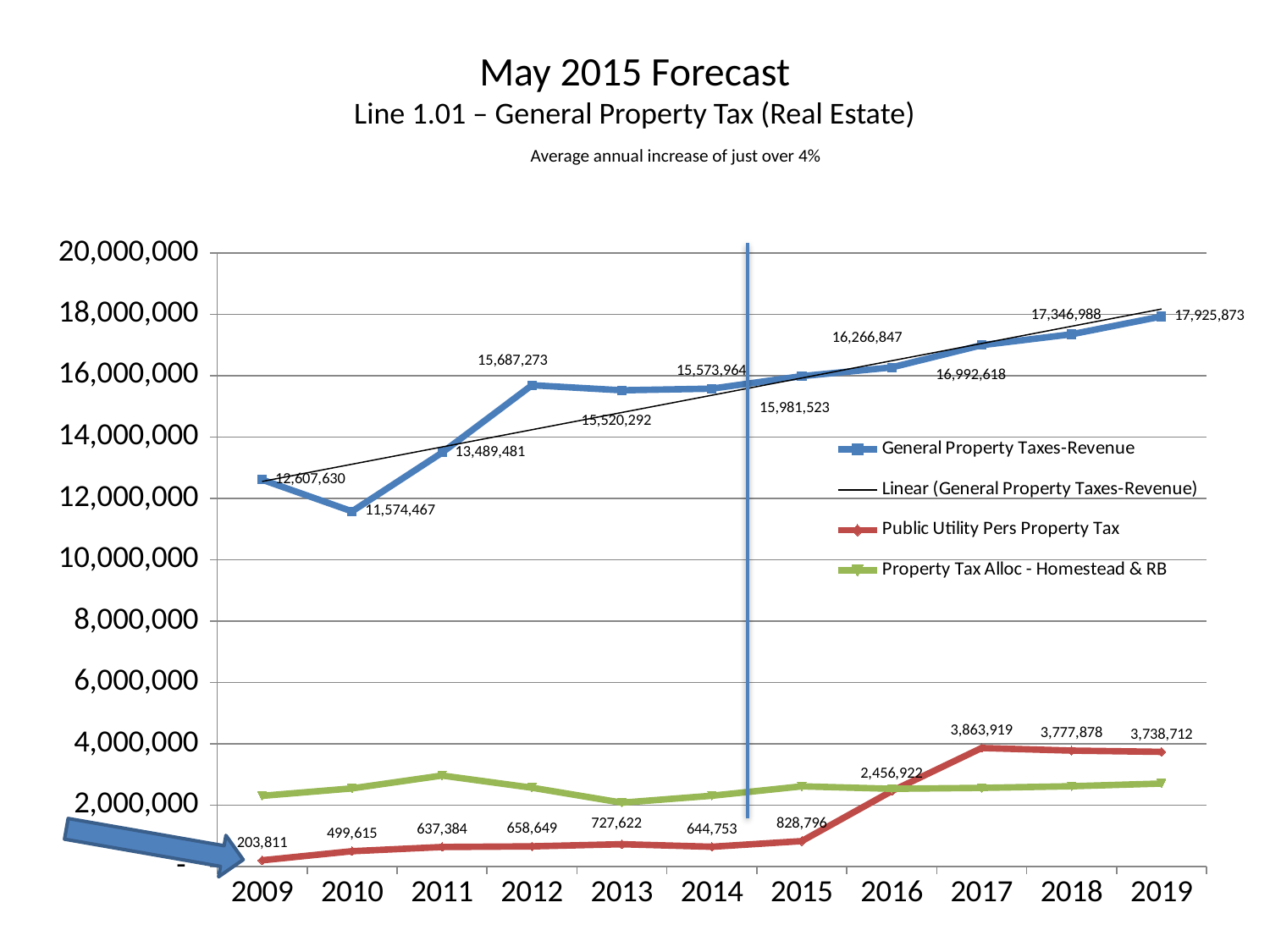
How many entries does the legend list? 4 How much higher is General Property Taxes-Revenue in 2019 than in 2009? 5,318,243 How many years are shown on the x axis? 11 Which year has the larger Public Utility Pers Property Tax value, 2018 or 2019? 2018 In which year is Public Utility Pers Property Tax highest? 2017 What is the General Property Taxes-Revenue value for 2019? 17,925,873 What is the Public Utility Pers Property Tax value for 2017? 3,863,919 In which year is General Property Taxes-Revenue lowest? 2010 What is the difference between the Public Utility Pers Property Tax values for 2017 and 2016? 1,406,997 Does General Property Taxes-Revenue rise or fall from 2014 to 2019? rise What kind of chart is shown on the slide? line chart Is the Property Tax Alloc - Homestead & RB value for 2011 greater or less than 2,000,000? greater